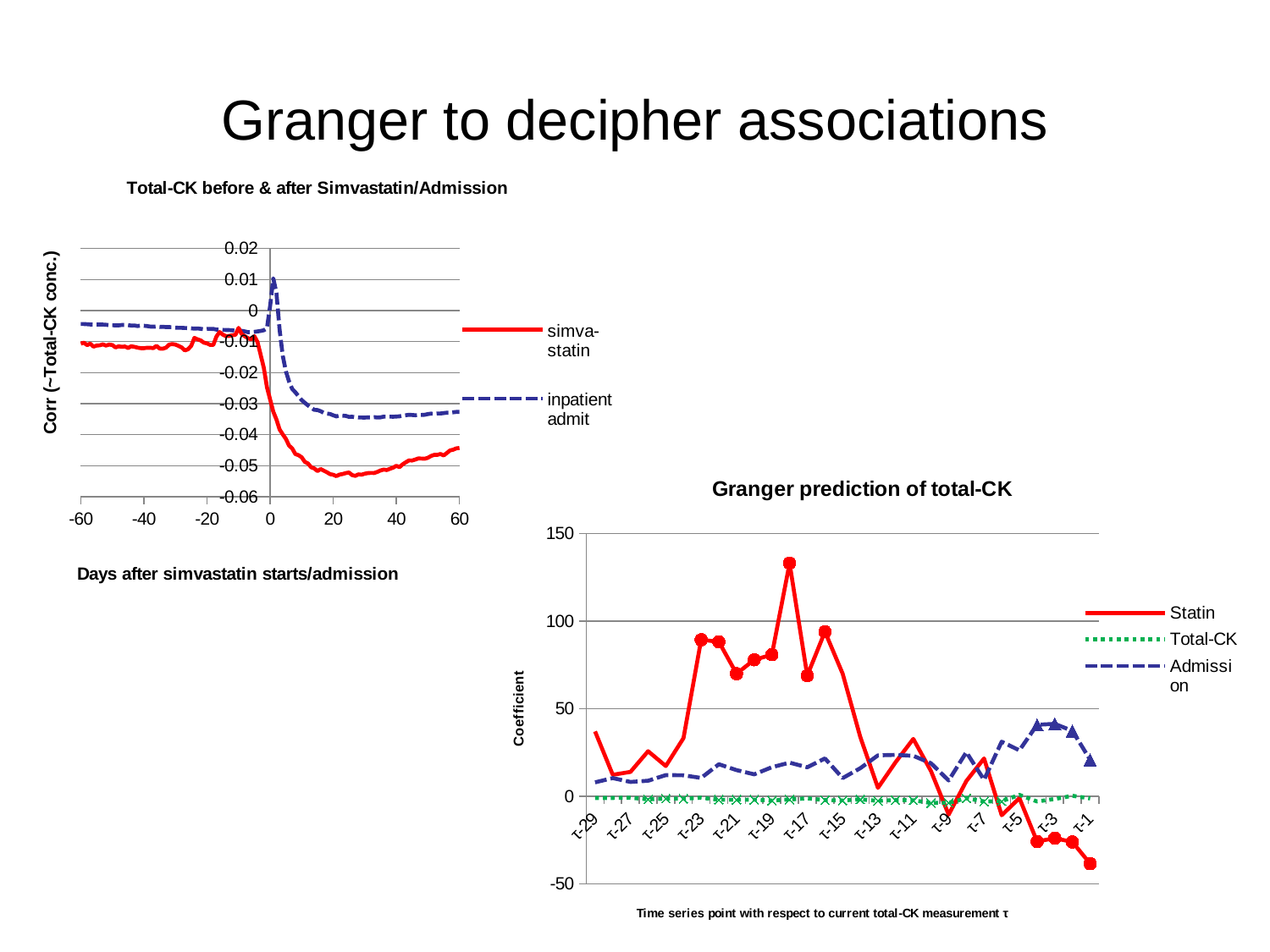
In the chart titled 'Total-CK before & after Simvastatin/Admission', what kind of chart is shown? line chart In the chart titled 'Total-CK before & after Simvastatin/Admission', at day 40, which series has the higher value, simvastatin or inpatient admit? inpatient admit In the chart titled 'Granger prediction of total-CK', is the Admission value at τ-3 greater or less than 50? less In the chart titled 'Granger prediction of total-CK', is the Statin value at τ-17 greater or less than 100? less In the chart titled 'Total-CK before & after Simvastatin/Admission', how many series does the legend list? 2 In the chart titled 'Granger prediction of total-CK', how many series does the legend list? 3 In the chart titled 'Granger prediction of total-CK', at τ-1, which series has the higher value, Statin or Admission? Admission In the chart titled 'Total-CK before & after Simvastatin/Admission', what is the x-axis title? Days after simvastatin starts/admission In the chart titled 'Total-CK before & after Simvastatin/Admission', is the inpatient admit value at day 40 greater or less than -0.02? less In the chart titled 'Granger prediction of total-CK', which series reaches the highest coefficient value? Statin In the chart titled 'Total-CK before & after Simvastatin/Admission', does the simvastatin line rise or fall between day 0 and day 20? fall